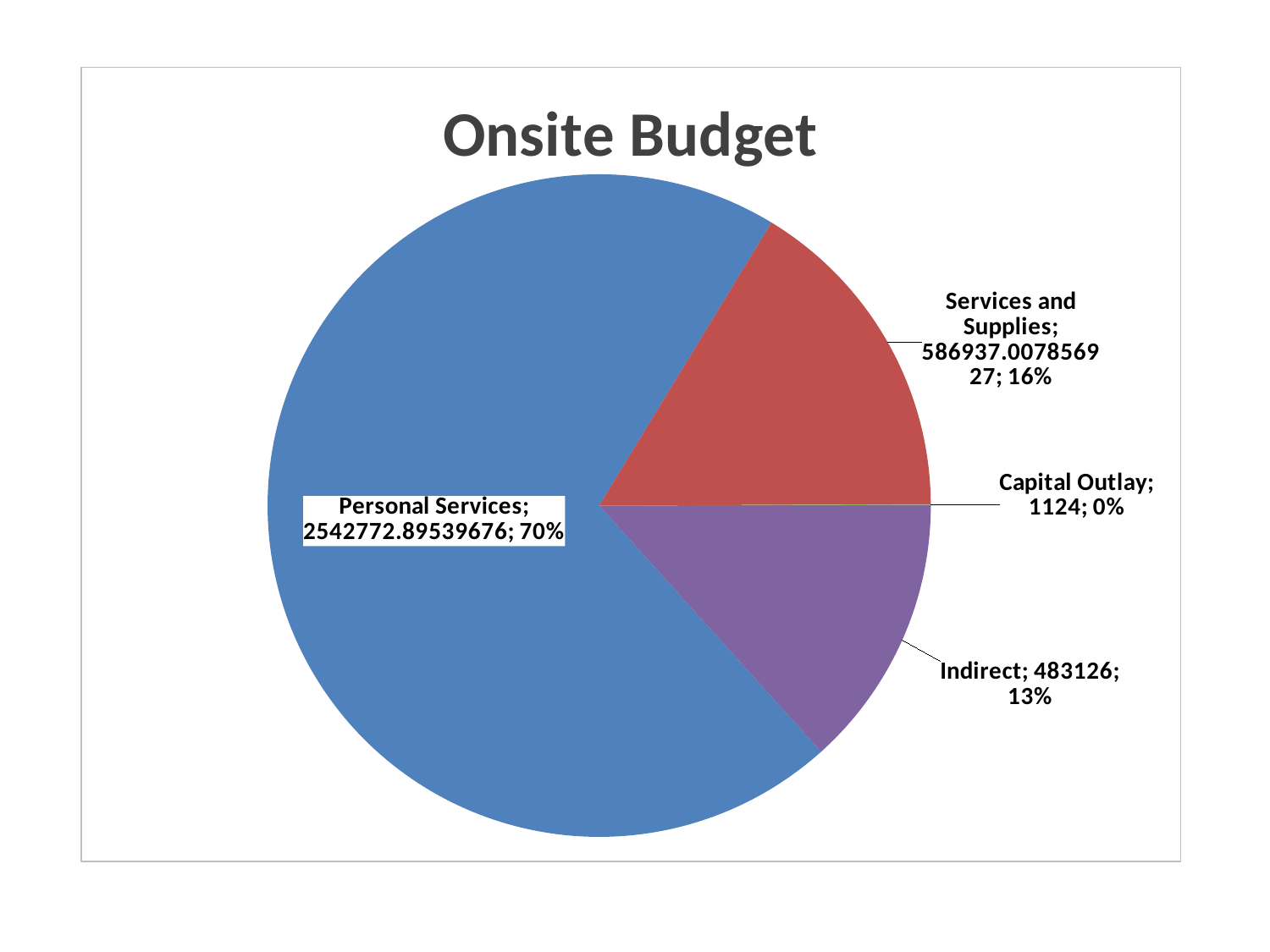
What value is shown for Indirect? 483126 What share of the Onsite Budget is Services and Supplies? 16% What share of the Onsite Budget is Personal Services? 70% How many slices does the pie chart have? 4 Which category has the smallest slice of the pie? Capital Outlay Which category has the largest slice of the pie? Personal Services What is the difference between the values for Indirect and Capital Outlay? 482002 What is the title of the chart? Onsite Budget What share of the Onsite Budget is Indirect? 13% What type of chart is shown on the slide? pie chart What value is shown for Capital Outlay? 1124 Which is larger, Services and Supplies or Indirect? Services and Supplies